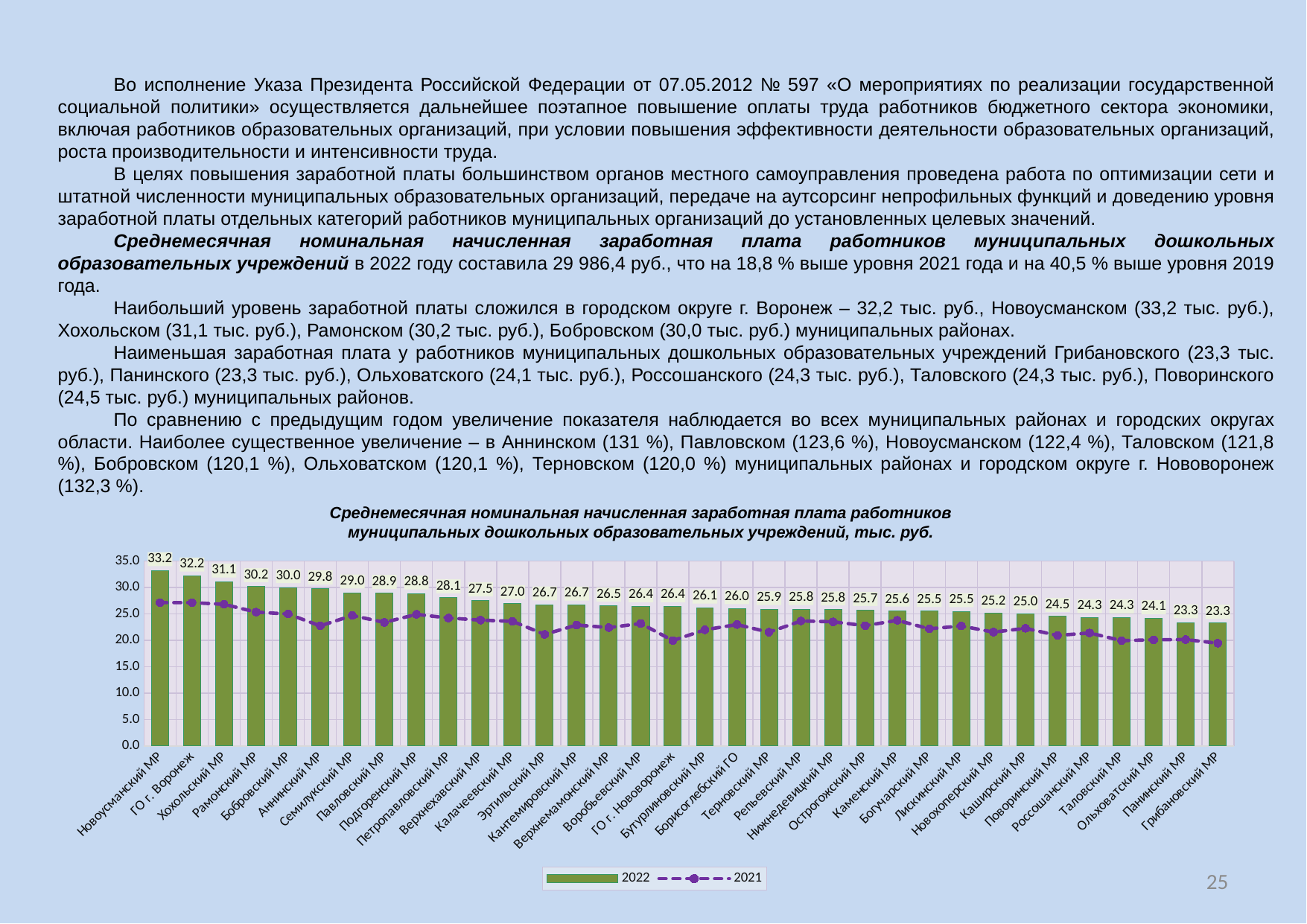
Do the 2022 values rise or fall from left to right along the x axis? fall What is the 2022 value for Ольховатский МР? 24.1 What is the difference between the 2022 values for Новоусманский МР and ГО г. Воронеж? 1.0 What is the 2022 value for Новоусманский МР? 33.2 How many series does the legend list? 2 Which has the larger 2022 value, Хохольский МР or Рамонский МР? Хохольский МР How many categories are shown on the x axis? 34 Is the 2021 value for Новоусманский МР greater or less than 25.0? greater Which category has the highest 2022 value? Новоусманский МР What is the 2022 value for Бобровский МР? 30.0 What is the 2022 value for ГО г. Воронеж? 32.2